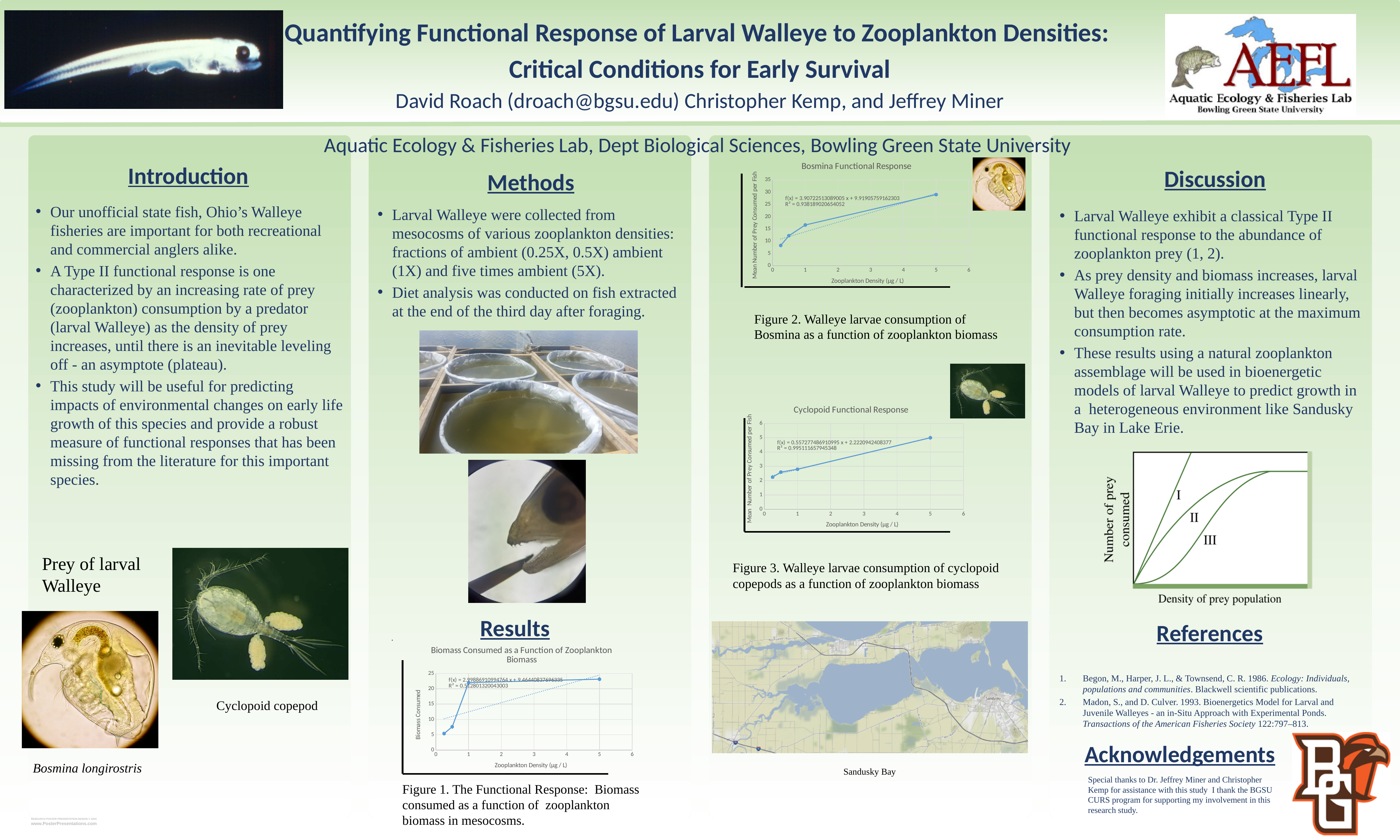
In the 'Cyclopoid Functional Response' chart, is the value at zooplankton density 5 greater or less than 4? greater In the 'Bosmina Functional Response' chart, do the values rise or fall as zooplankton density increases? rise What is the x-axis label of the 'Biomass Consumed as a Function of Zooplankton Biomass' chart? Zooplankton Density (µg / L) In the 'Bosmina Functional Response' chart, how many data points are plotted? 4 In the 'Bosmina Functional Response' chart, what R² value is printed for the trendline? 0.938189020654052 What kind of chart is the 'Bosmina Functional Response' chart? line chart In the 'Biomass Consumed as a Function of Zooplankton Biomass' chart, is the value at zooplankton density 1 greater or less than 15? greater In the 'Cyclopoid Functional Response' chart, what R² value is printed for the trendline? 0.995111657945348 In the 'Biomass Consumed as a Function of Zooplankton Biomass' chart, which zooplankton density has the lowest biomass consumed? 0.25 In the 'Bosmina Functional Response' chart, is the value at zooplankton density 5 greater or less than 25? greater What is the y-axis label of the 'Cyclopoid Functional Response' chart? Mean Number of Prey Consumed per Fish In the 'Cyclopoid Functional Response' chart, which zooplankton density has the highest mean number of prey consumed per fish? 5